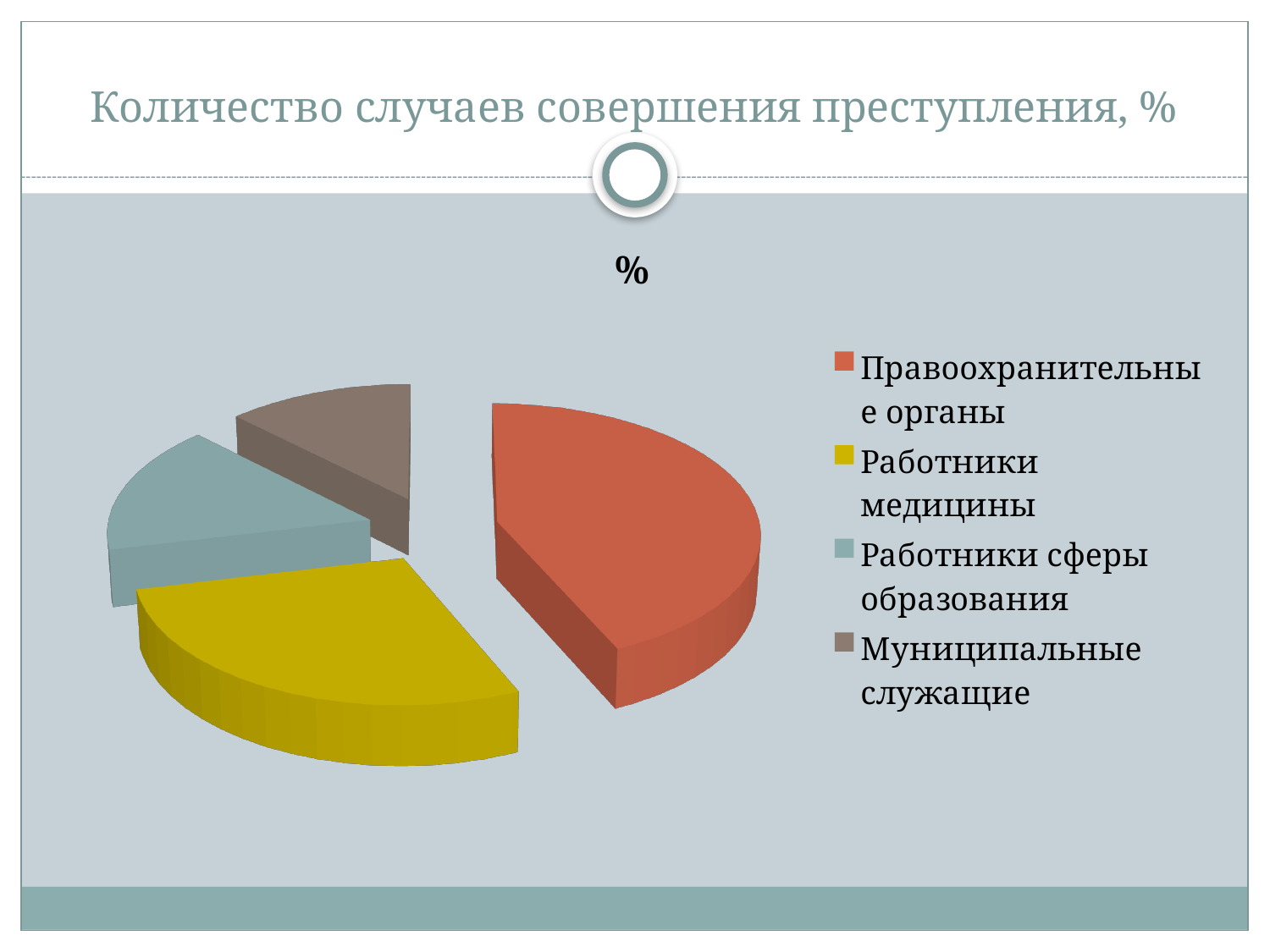
Which slice is larger: Правоохранительные органы or Работники медицины? Правоохранительные органы Which slice is larger: Работники медицины or Работники сферы образования? Работники медицины How many slices does the pie chart have? 4 Which slice is larger: Работники сферы образования or Правоохранительные органы? Правоохранительные органы Which category is shown in yellow in the pie chart? Работники медицины How many entries does the legend of the pie chart list? 4 What kind of chart is shown on the slide? pie chart What is the title shown above the pie chart? % Which category has the largest slice in the pie chart? Правоохранительные органы